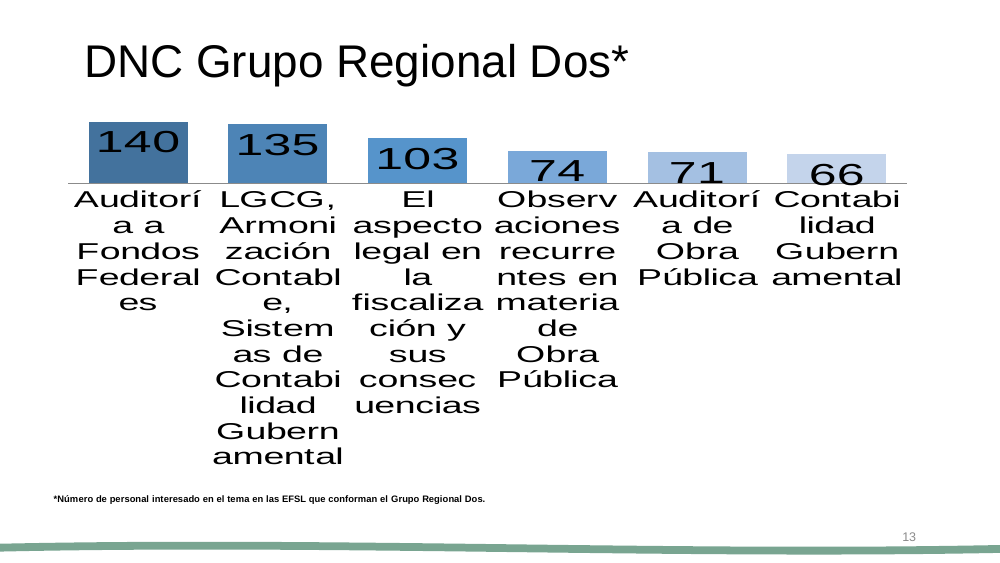
What is the value for Contabilidad Gubernamental? 66 What is the value for Auditoría de Obra Pública? 71 What kind of chart is shown on the slide? Bar chart Which is larger: the value for Observaciones recurrentes en materia de Obra Pública or the value for Contabilidad Gubernamental? Observaciones recurrentes en materia de Obra Pública What is the value for Auditoría a Fondos Federales? 140 Which category has the highest value? Auditoría a Fondos Federales How many categories are shown in the chart? 6 What is the difference between the values for El aspecto legal en la fiscalización y sus consecuencias and Observaciones recurrentes en materia de Obra Pública? 29 Do the values rise or fall from left to right across the categories? Fall What is the difference between the values for Auditoría a Fondos Federales and LGCG, Armonización Contable, Sistemas de Contabilidad Gubernamental? 5 What is the value for El aspecto legal en la fiscalización y sus consecuencias? 103 Which category has the lowest value? Contabilidad Gubernamental